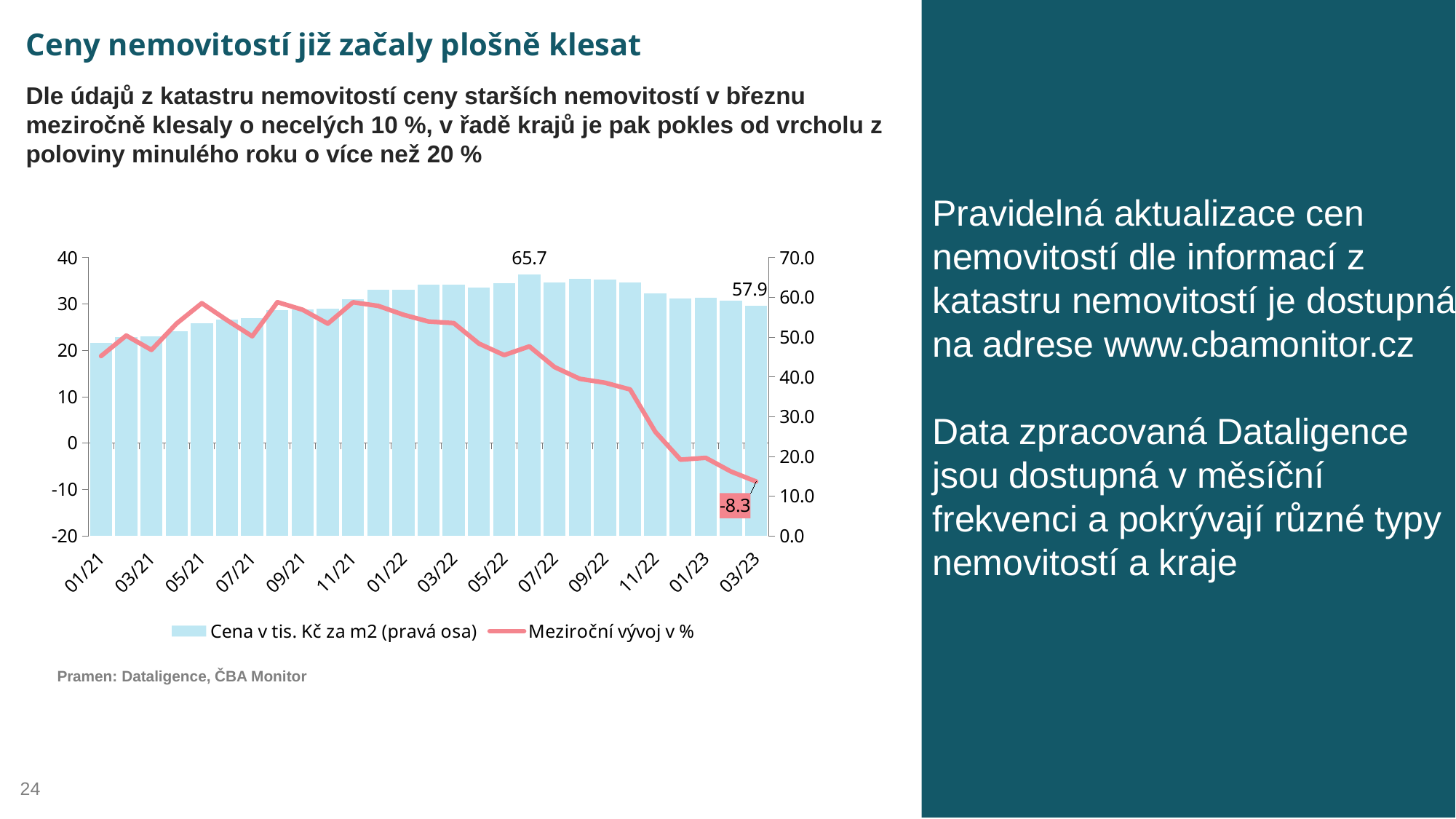
How many series does the legend list? 2 What is the difference between the peak bar value 65.7 and the 03/23 bar value 57.9? 7.8 What kind of chart is shown on the slide? A combined bar and line chart What is the value of the bar 'Cena v tis. Kč za m2 (pravá osa)' for 03/23? 57.9 Which is higher on the 'Meziroční vývoj v %' line: 01/22 or 01/23? 01/22 Does the 'Meziroční vývoj v %' line rise or fall between 09/22 and 03/23? Fall What is the maximum value shown on the right-hand axis? 70.0 What is the value of 'Meziroční vývoj v %' for 03/23? -8.3 Is the 'Meziroční vývoj v %' value for 01/23 greater or less than 0? less What is the highest value labelled on the bars for 'Cena v tis. Kč za m2 (pravá osa)'? 65.7 Is the 'Meziroční vývoj v %' value for 05/21 greater or less than 20? greater Is the 'Cena v tis. Kč za m2 (pravá osa)' bar for 01/21 greater or less than 40.0 on the right axis? greater